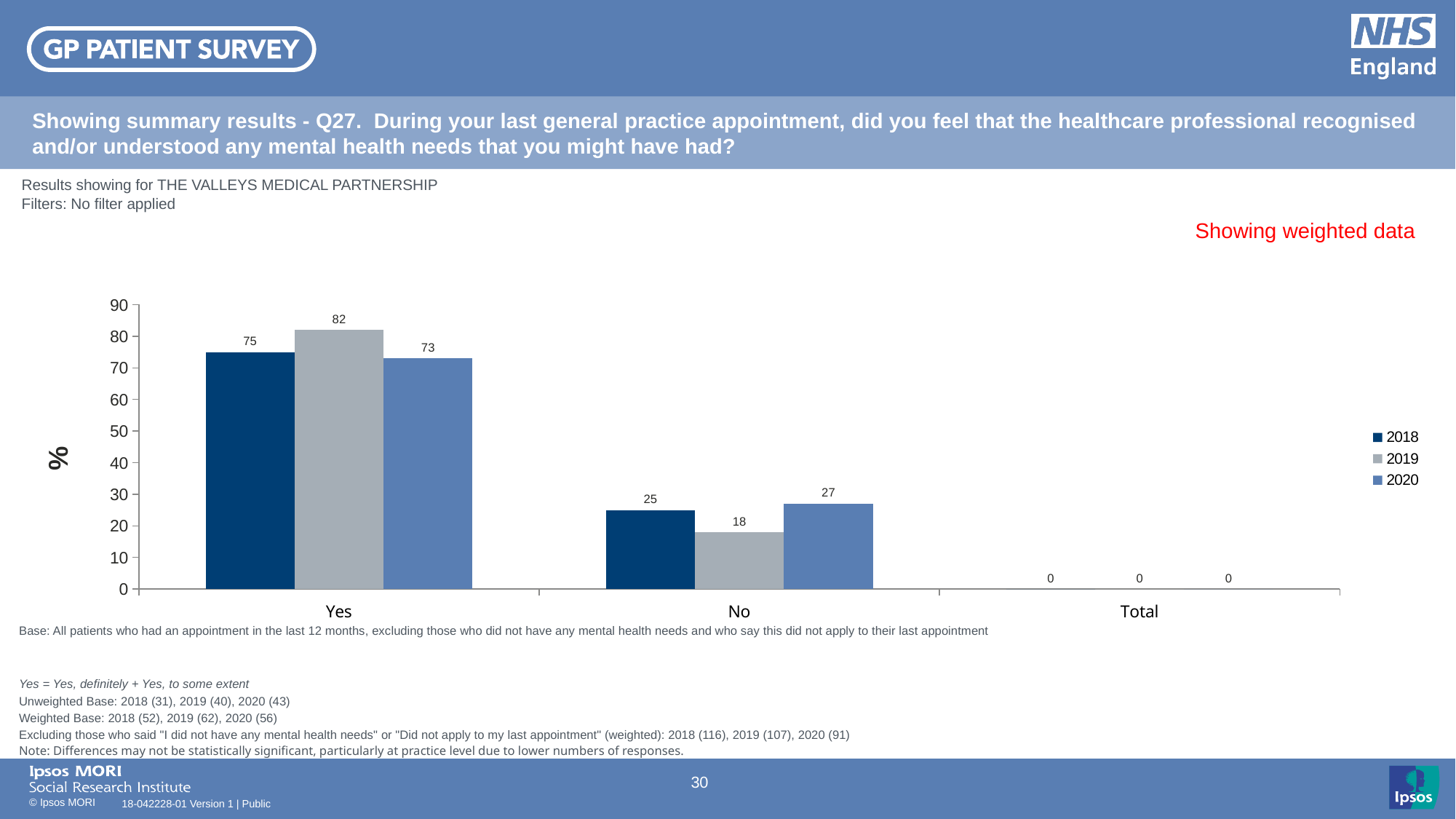
What is the difference between the 'Yes' values for 2019 and 2020? 9 How many categories are shown on the x axis? 3 What is the difference between the 'No' values for 2020 and 2018? 2 Which year has the highest value for 'Yes'? 2019 How many series does the legend list? 3 Which is larger: the 'Yes' value for 2018 or the 'Yes' value for 2020? 2018 What kind of chart is shown on the slide? Bar chart What is the label on the y axis? % What is the value for 'No' in 2020? 27 What is the value for 'Yes' in 2018? 75 What is the value for 'Yes' in 2019? 82 Which year has the lowest value for 'No'? 2019